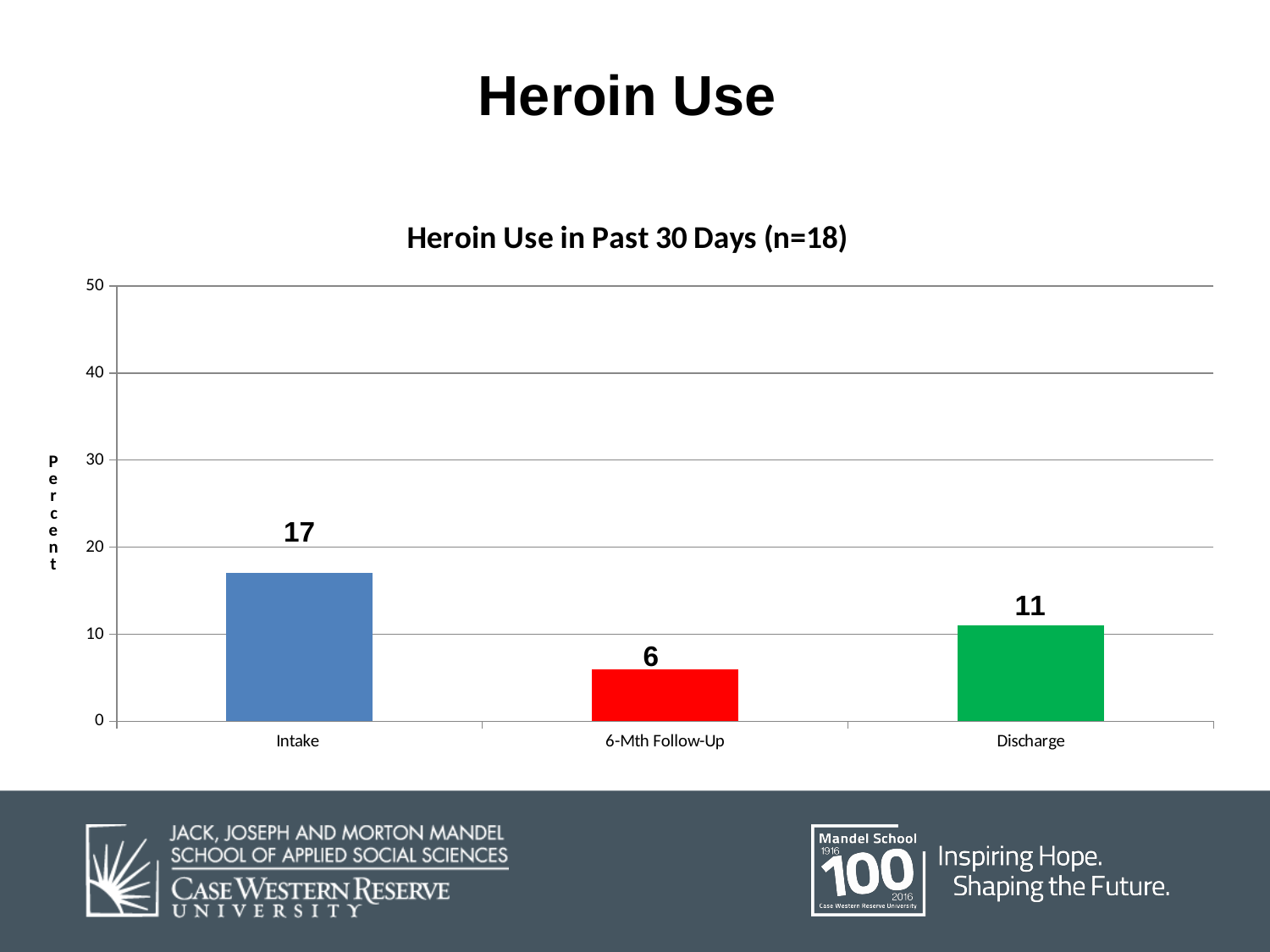
What is the difference between the values for Intake and Discharge? 6 What is the value for Intake? 17 Which category has the lowest value? 6-Mth Follow-Up How many categories are shown on the x axis? 3 What kind of chart is shown on the slide? bar chart What is the difference between the values for Discharge and 6-Mth Follow-Up? 5 What is the value for 6-Mth Follow-Up? 6 Which category has the highest value? Intake What is the value for Discharge? 11 Is the value for Intake greater or less than 20? less What is the title of the chart? Heroin Use in Past 30 Days (n=18) Which is larger, the value for Intake or the value for Discharge? Intake